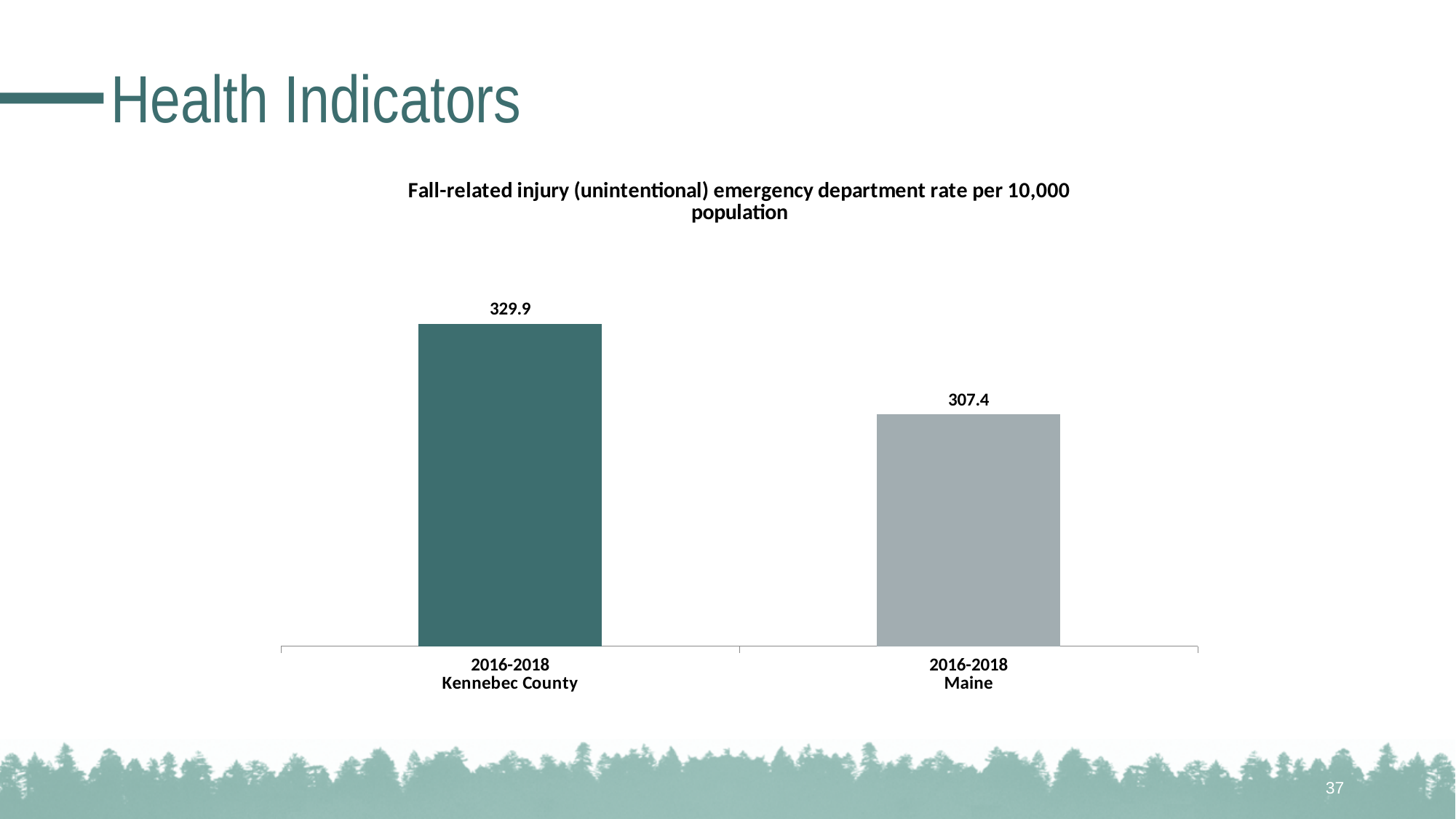
Which has the higher fall-related injury emergency department rate, Kennebec County or Maine? Kennebec County Which has the lower fall-related injury emergency department rate, Kennebec County or Maine? Maine What is the fall-related injury emergency department rate per 10,000 population for Maine in 2016-2018? 307.4 Is the Maine rate larger or smaller than the Kennebec County rate? smaller How many bars are shown in the chart? 2 What kind of chart is shown on the slide? bar chart What is the fall-related injury emergency department rate per 10,000 population for Kennebec County in 2016-2018? 329.9 What time period do the bars in the chart cover? 2016-2018 What is the title of the chart? Fall-related injury (unintentional) emergency department rate per 10,000 population What is the difference between the Kennebec County rate and the Maine rate? 22.5